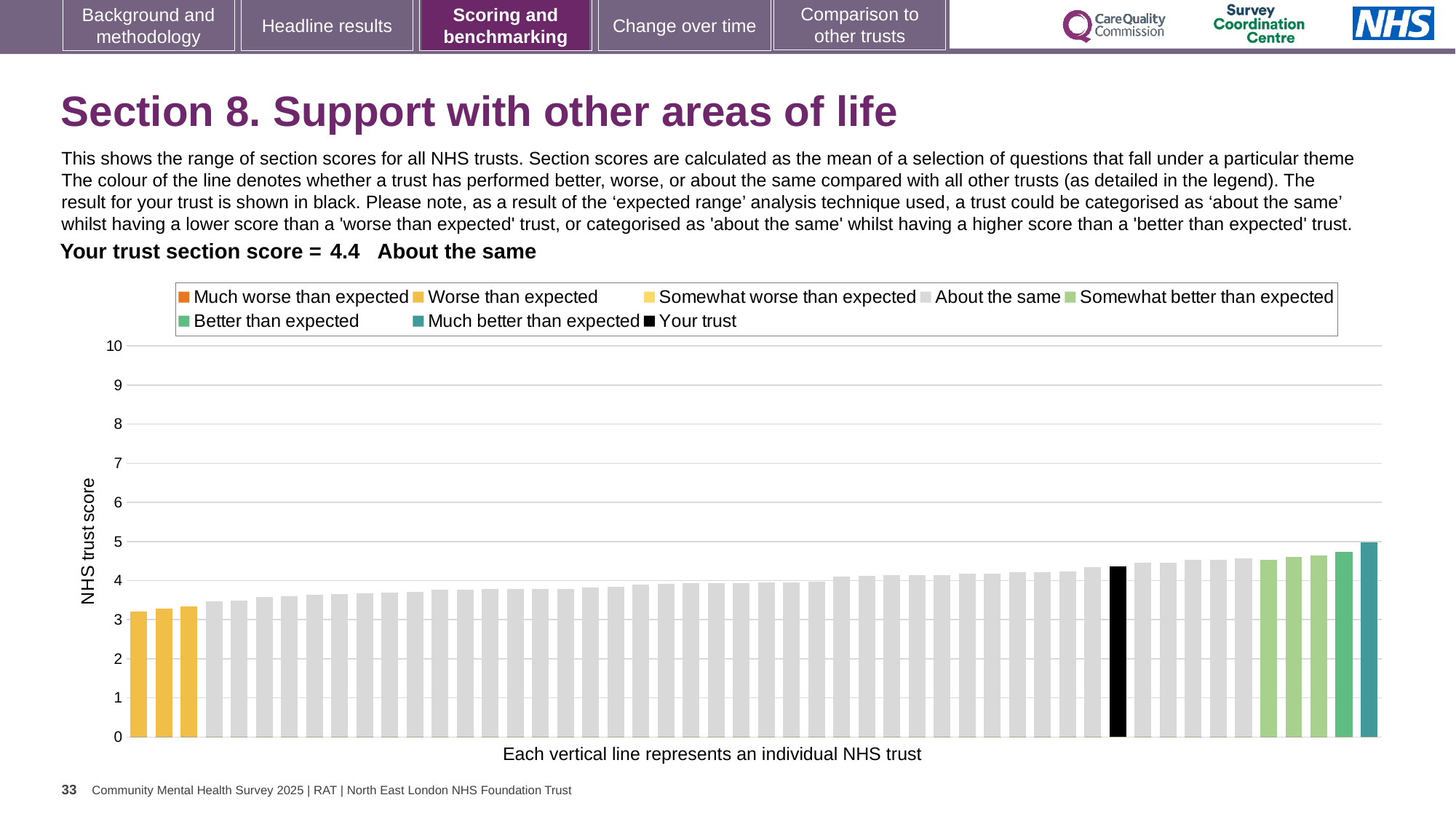
Which category is your trust's section score placed in? About the same Is the value for the shortest bar in the chart greater or less than 4? less Is the value for your trust's bar greater or less than 4? greater How many entries does the chart legend list? 8 Do the bar values rise or fall from left to right along the x axis? rise What kind of chart is shown on the slide? bar chart What colour is the bar representing your trust? black Is the value for the shortest bar in the chart greater or less than 3? greater What is the section score for your trust shown on the slide? 4.4 What is the title of the vertical axis? NHS trust score